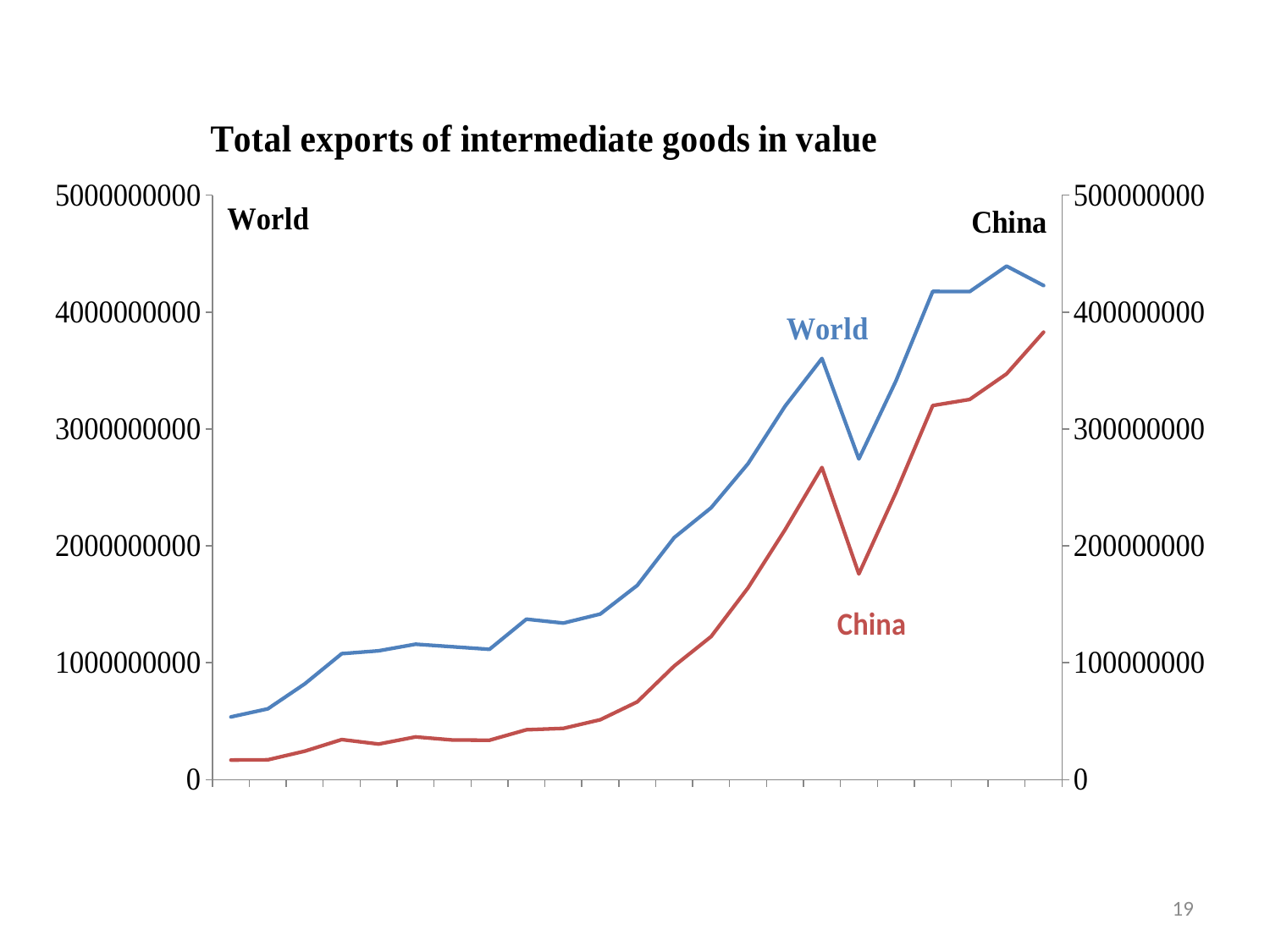
What is the title of the chart? Total exports of intermediate goods in value Is the value of the China line at its sharp dip after the first peak greater or less than 200000000 on the right axis? less Do the China values generally rise or fall from left to right along the x axis? rise Is the highest value of the World line greater or less than 4000000000 on the left axis? greater Is the value of the World line at its sharp dip after the first peak greater or less than 3000000000 on the left axis? less What colour is the World line? blue How many series are plotted on the chart? 2 What kind of chart is shown on the slide? line chart Do the World values generally rise or fall from left to right along the x axis? rise